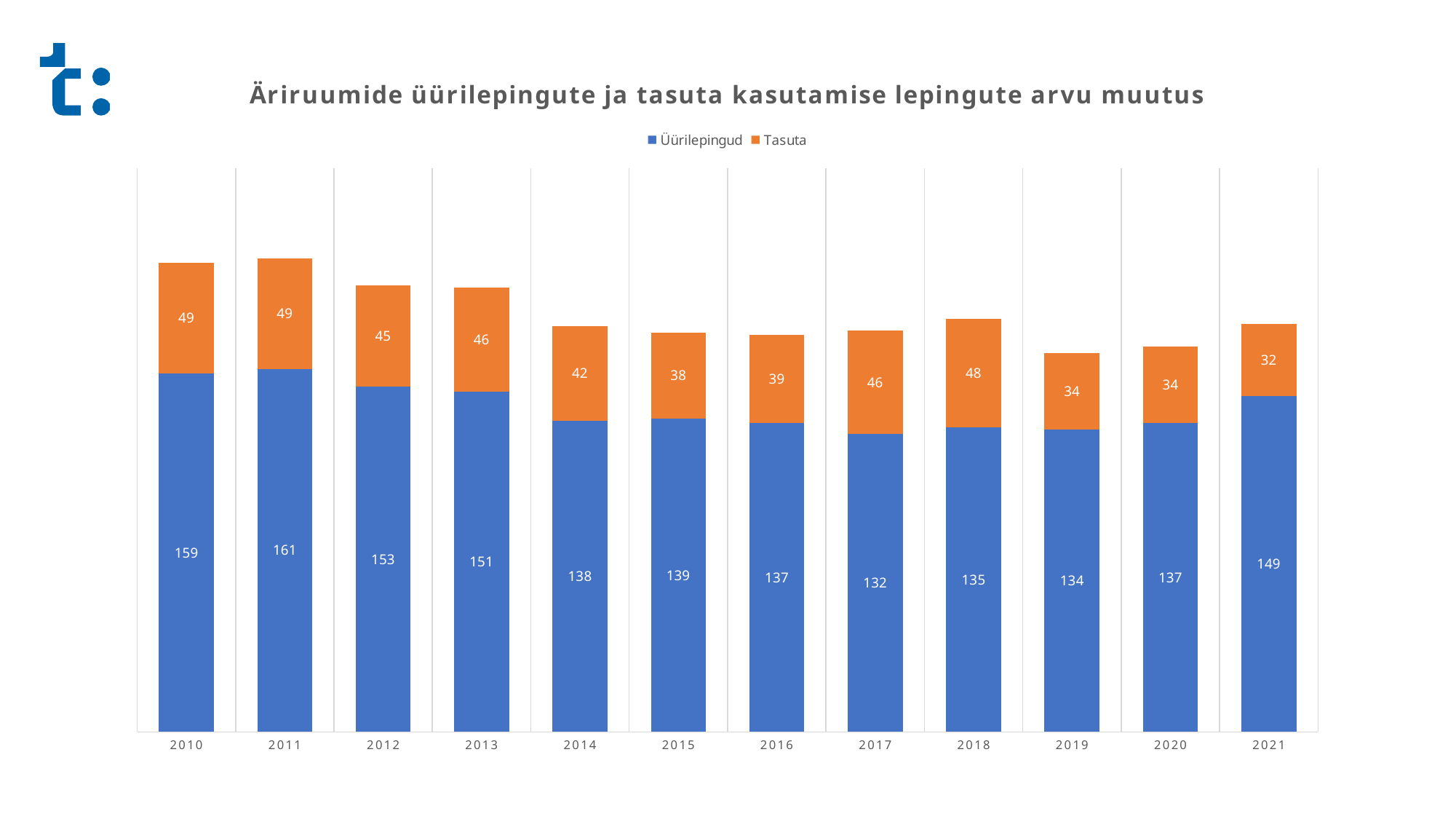
Which year has the lowest value for Tasuta? 2021 What is the total of the stacked bar for 2010? 208 What kind of chart is shown on the slide? Stacked bar chart What is the value of Tasuta for 2018? 48 How many series does the legend list? 2 Which is larger, the Tasuta value for 2013 or for 2015? 2013 What is the difference between the Üürilepingud values for 2011 and 2017? 29 What is the total of the stacked bar for 2019? 168 Which year has the highest value for Üürilepingud? 2011 What is the value of Üürilepingud for 2021? 149 How many years are shown on the x axis? 12 What is the value of Üürilepingud for 2010? 159